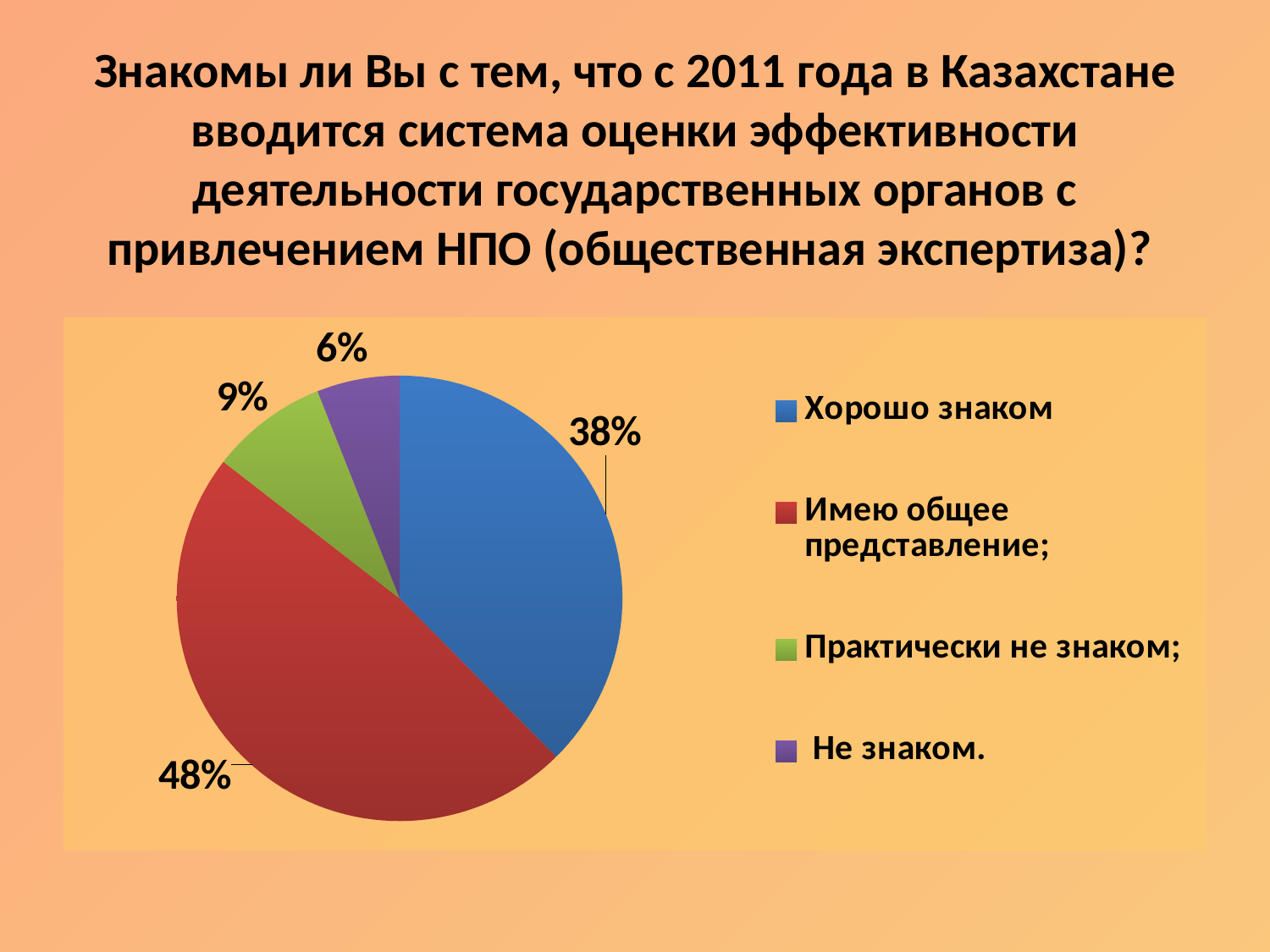
Which category has the smallest slice of the pie? Не знаком. Which category has the largest slice of the pie? Имею общее представление; What share of the pie is labelled "Имею общее представление;"? 48% How many categories does the pie chart have? 4 What share of the pie is labelled "Не знаком."? 6% What share of the pie is labelled "Хорошо знаком"? 38% What kind of chart is shown on the slide? pie chart What colour is the slice for "Хорошо знаком"? blue Which is larger: the slice for "Практически не знаком;" or the slice for "Не знаком."? Практически не знаком; What is the difference in percentage points between "Имею общее представление;" and "Хорошо знаком"? 10 What share of the pie is labelled "Практически не знаком;"? 9% What is the combined share of "Практически не знаком;" and "Не знаком."? 15%